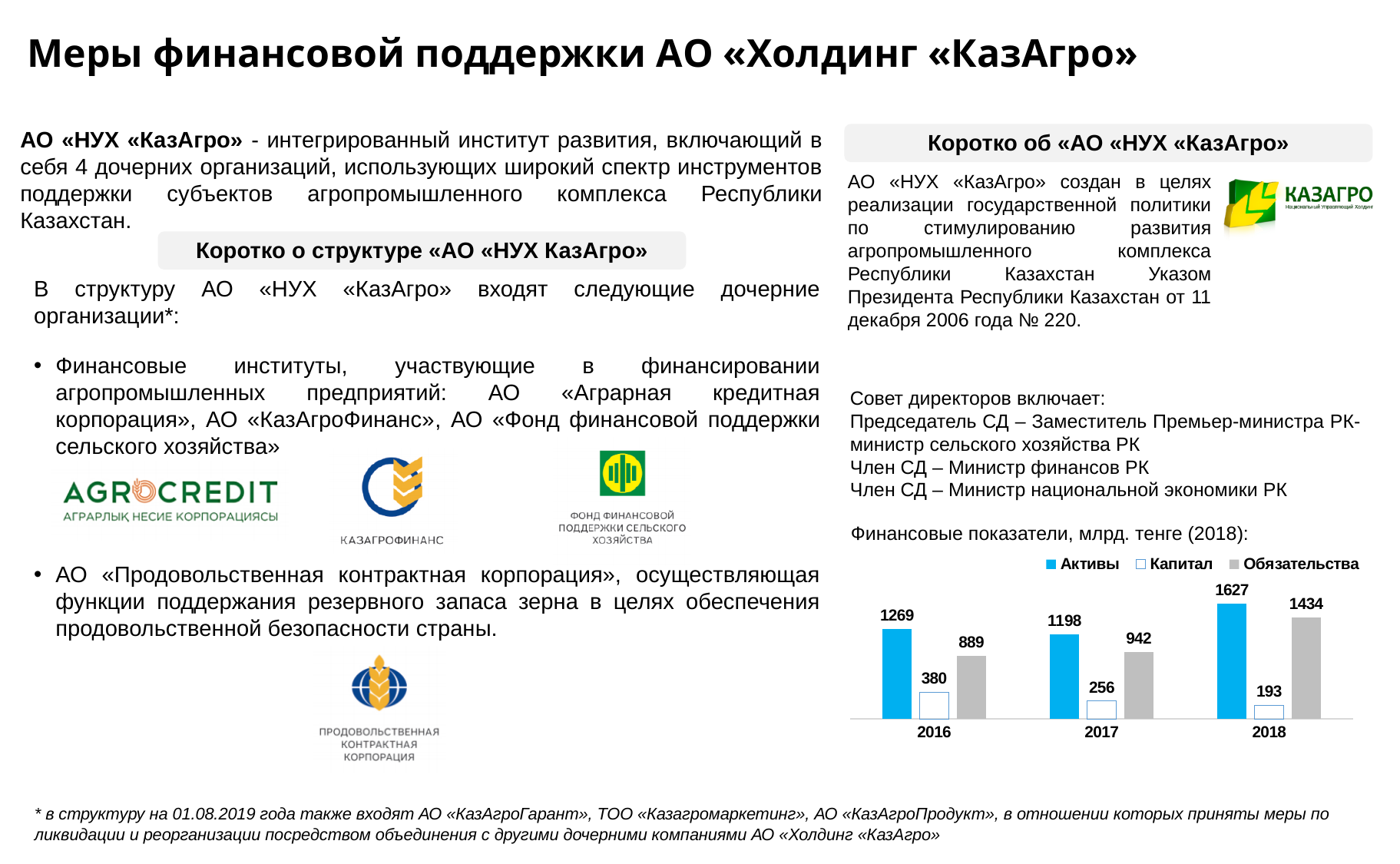
What is the value of Капитал for 2016 in the chart? 380 In which year is Капитал lowest in the chart? 2018 What is the value of Активы for 2018 in the chart? 1627 What is the difference between Активы and Обязательства in 2018? 193 How many series does the chart legend list? 3 What is the difference between Капитал in 2016 and Капитал in 2017? 124 How many years are shown on the x axis of the chart? 3 Which is larger in 2017: Активы or Обязательства? Активы What is the value of Обязательства for 2017 in the chart? 942 Does Капитал rise or fall from 2016 to 2018 in the chart? Fall What kind of chart is shown on the slide? Bar chart In which year is Активы highest in the chart? 2018